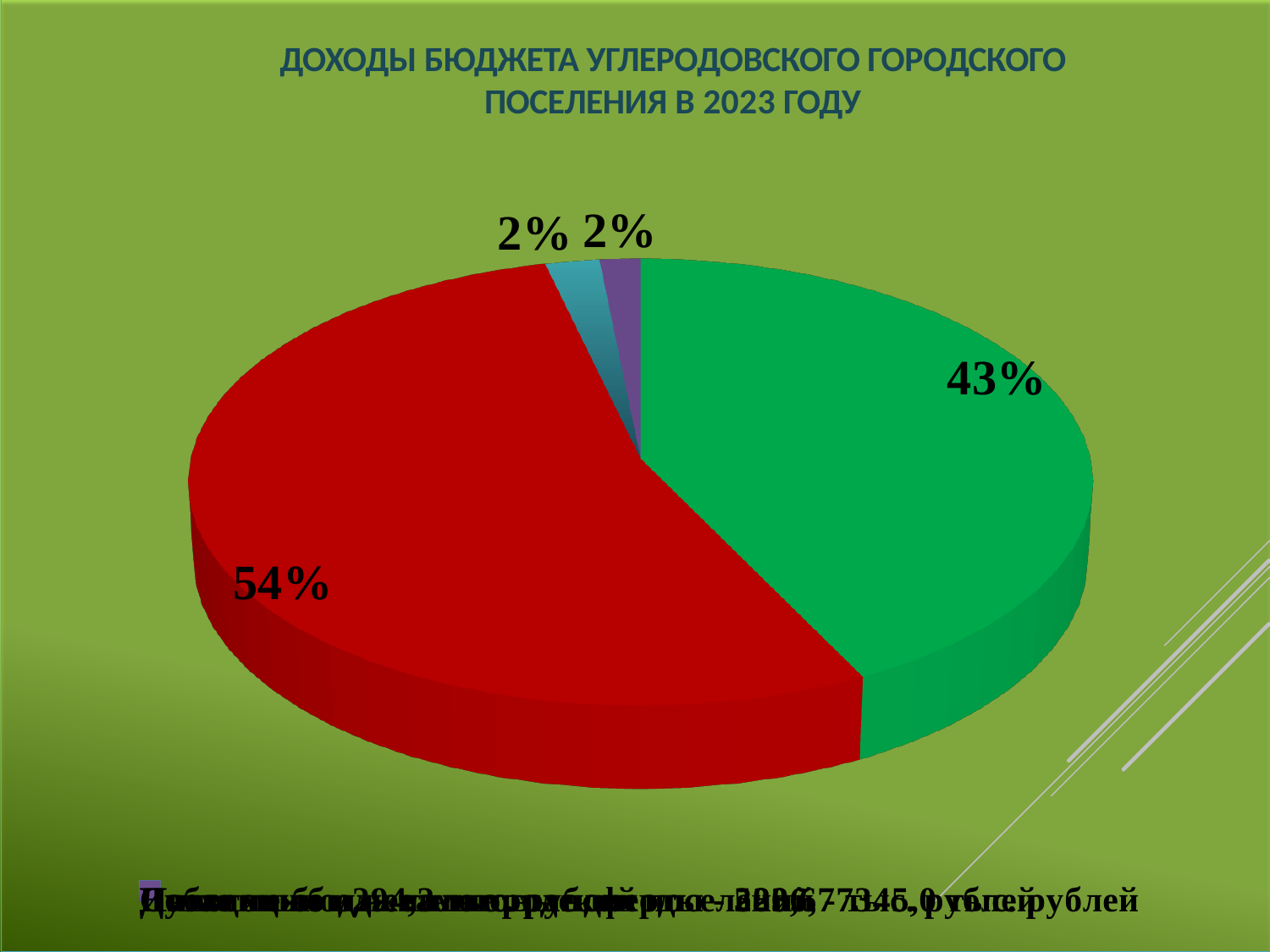
What share of the pie does the teal slice represent? 2% What share of the pie does the purple slice represent? 2% What share of the pie does the red slice represent? 54% Which slice of the pie chart is the largest? the red slice (54%) What is the percentage shown on the largest slice of the pie? 54% What is the combined share of the red and green slices? 97% Which is larger, the red slice or the green slice? the red slice How many slices does the pie chart have? 4 What kind of chart is shown on the slide? pie chart What is the difference in percentage points between the red slice and the green slice? 11 What is the title of the chart? ДОХОДЫ БЮДЖЕТА УГЛЕРОДОВСКОГО ГОРОДСКОГО ПОСЕЛЕНИЯ В 2023 ГОДУ